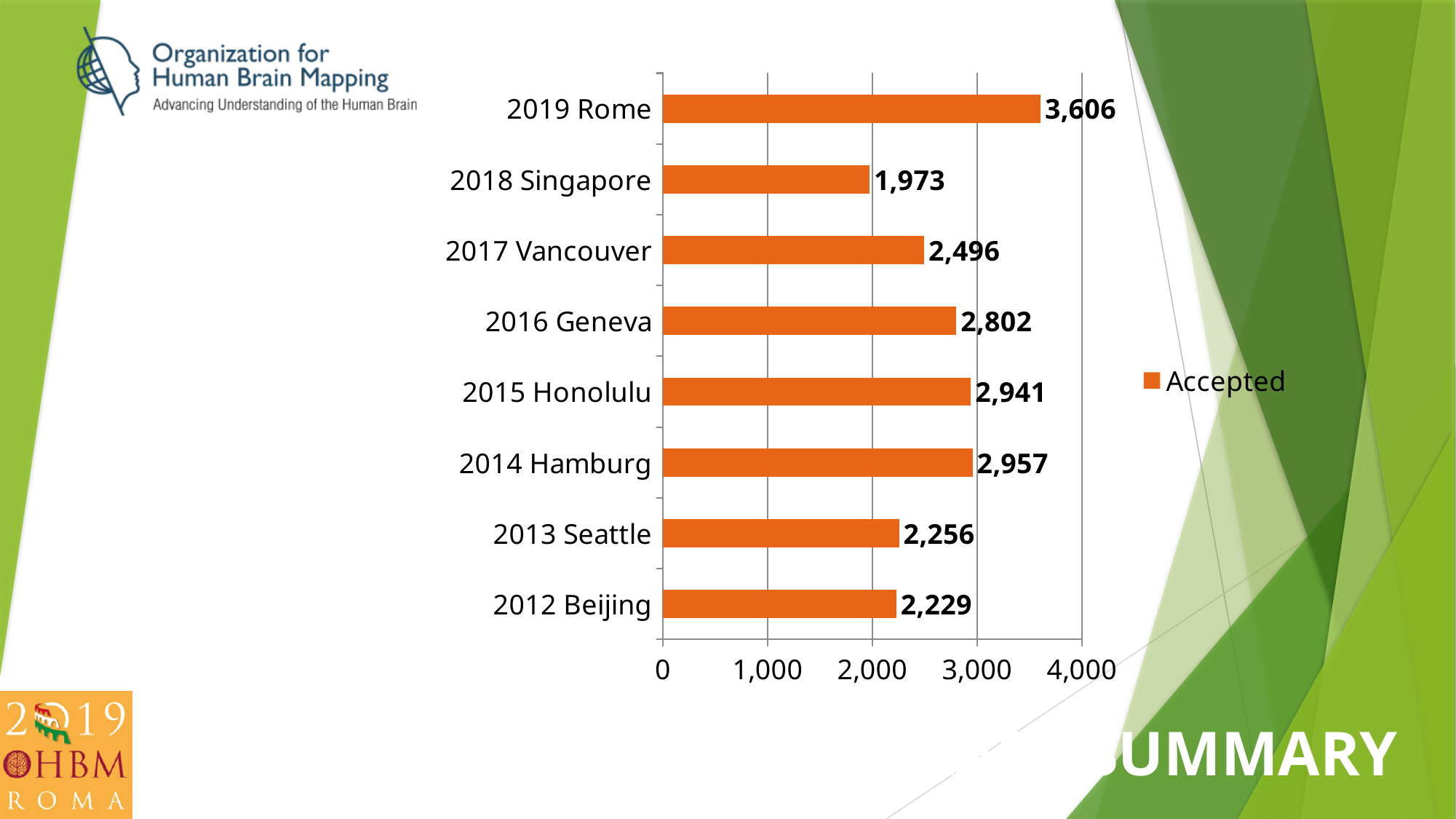
Is the Accepted value for 2018 Singapore greater or less than 2,000? less How many series does the legend list? 1 What kind of chart is shown on the slide? bar chart Which category has the lowest Accepted value? 2018 Singapore Which category has the highest Accepted value? 2019 Rome Which has a larger Accepted value, 2017 Vancouver or 2013 Seattle? 2017 Vancouver How many categories are shown in the chart? 8 What is the Accepted value for 2012 Beijing? 2,229 What is the difference between the Accepted values for 2014 Hamburg and 2015 Honolulu? 16 What is the Accepted value for 2019 Rome? 3,606 What is the Accepted value for 2016 Geneva? 2,802 What is the difference between the Accepted values for 2019 Rome and 2018 Singapore? 1,633